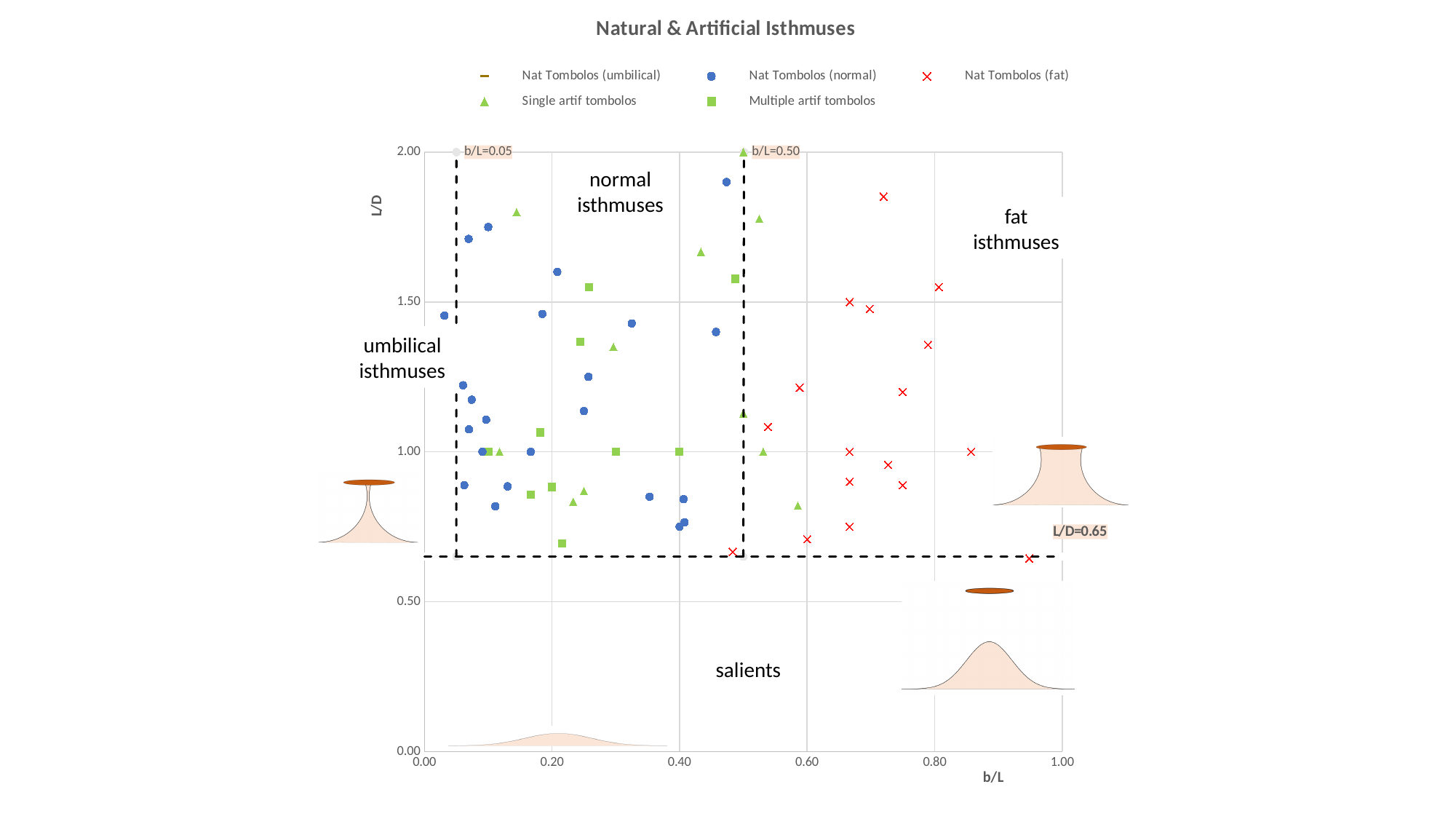
Is the lowest L/D value among the Nat Tombolos (fat) points greater or less than 1.00? less How many series does the chart's legend list? 5 Which region label appears to the right of the b/L=0.50 dashed line, above the L/D=0.65 line? fat isthmuses What kind of chart is shown on the slide? scatter chart What is the label of the vertical axis? L/D Is the highest L/D value among the Nat Tombolos (fat) points greater or less than 1.50? greater What is the label of the horizontal axis? b/L What is the highest tick value shown on the vertical (L/D) axis? 2.00 At what L/D value is the horizontal dashed line drawn, according to its label? L/D=0.65 What is the highest tick value shown on the horizontal (b/L) axis? 1.00 What are the labels of the two vertical dashed lines? b/L=0.05 and b/L=0.50 What is the title of the chart? Natural & Artificial Isthmuses